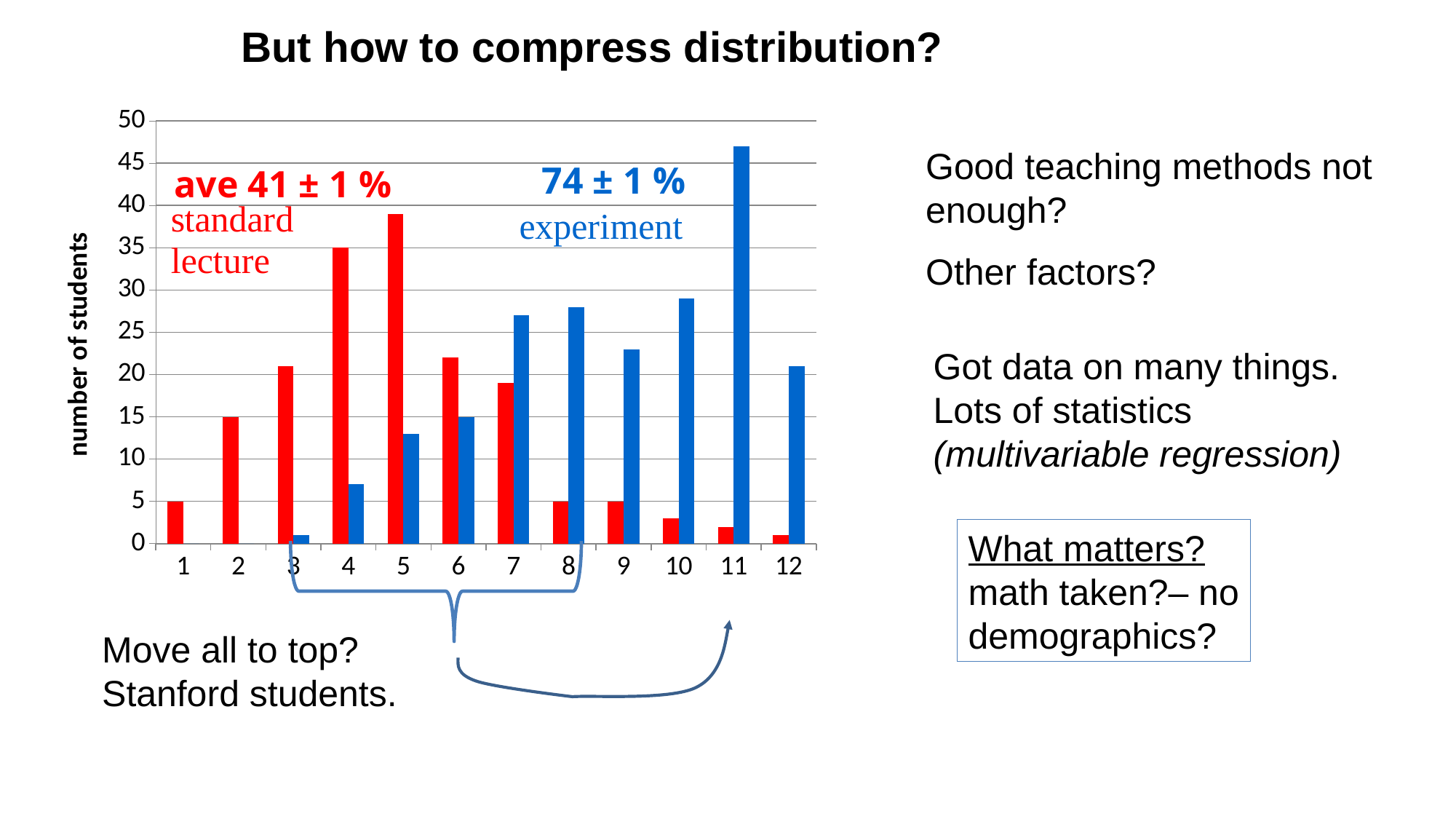
At which category is the experiment (blue) series highest? 11 What kind of chart is shown on the slide? bar chart At category 7, which series has the larger value, standard lecture (red) or experiment (blue)? experiment (blue) Is the value for the experiment (blue) series at category 4 greater or less than 10? less What is the number of students for the experiment (blue) series at category 6? 15 What is the number of students for the standard lecture (red) series at category 2? 15 What is the label of the y axis? number of students Is the value for the experiment (blue) series at category 11 greater or less than 45? greater How many categories are shown along the x axis? 12 How many data series does the chart show? 2 What is the number of students for the standard lecture (red) series at category 4? 35